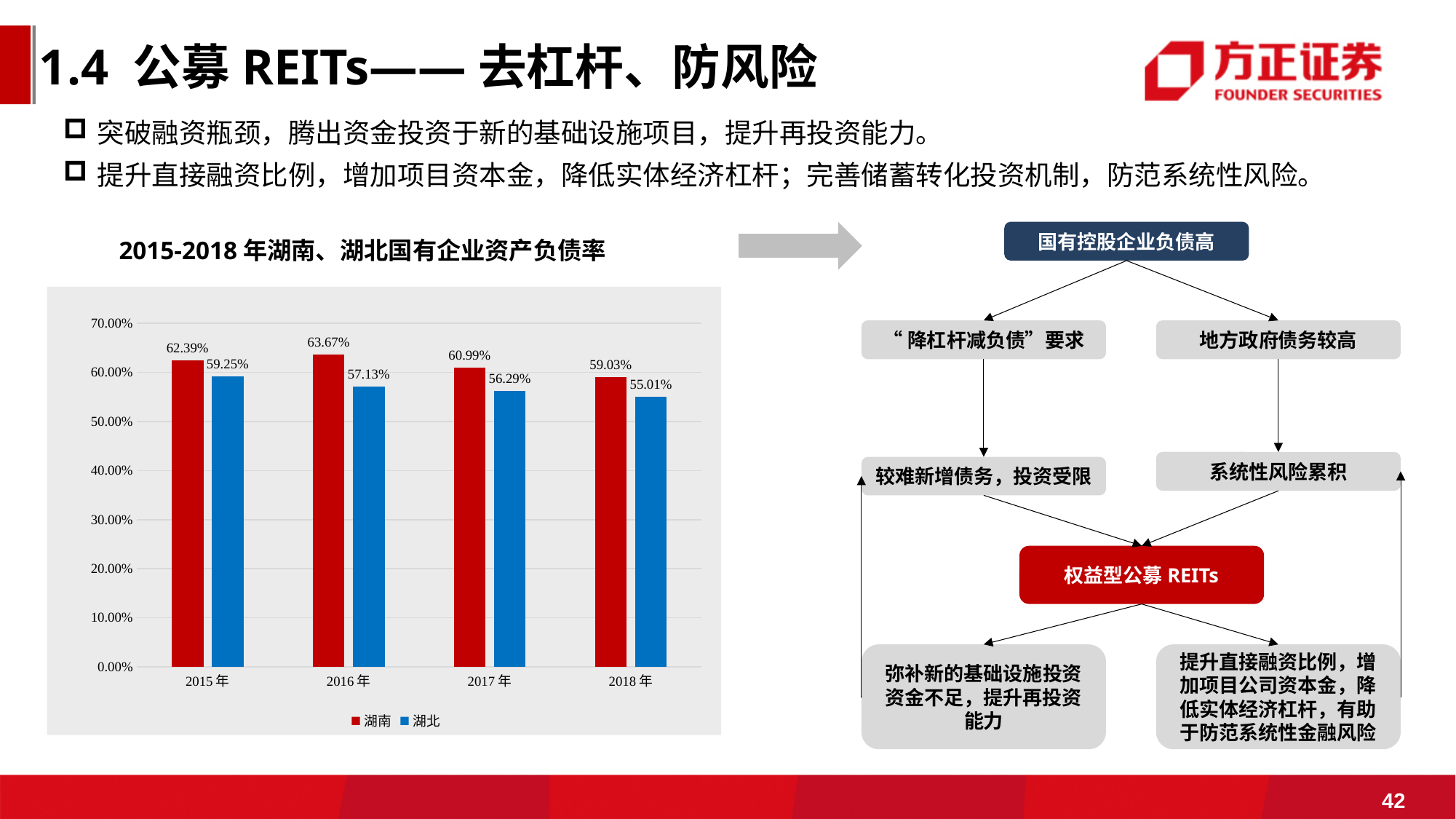
Does the 湖北 value rise or fall from 2015 年 to 2018 年? fall What is the value for 湖南 in 2015 年? 62.39% What kind of chart is shown on the slide? bar chart Which is larger in 2015 年, the value for 湖南 or for 湖北? 湖南 What is the value for 湖南 in 2016 年? 63.67% What is the difference between the 湖南 and 湖北 values in 2017 年? 4.70% Is the value for 湖北 in 2016 年 greater or less than 60.00%? less In which year is the 湖南 value highest? 2016 年 What is the value for 湖北 in 2018 年? 55.01% How many years are shown on the x axis of the chart? 4 How many series does the chart legend list? 2 In which year is the 湖北 value lowest? 2018 年